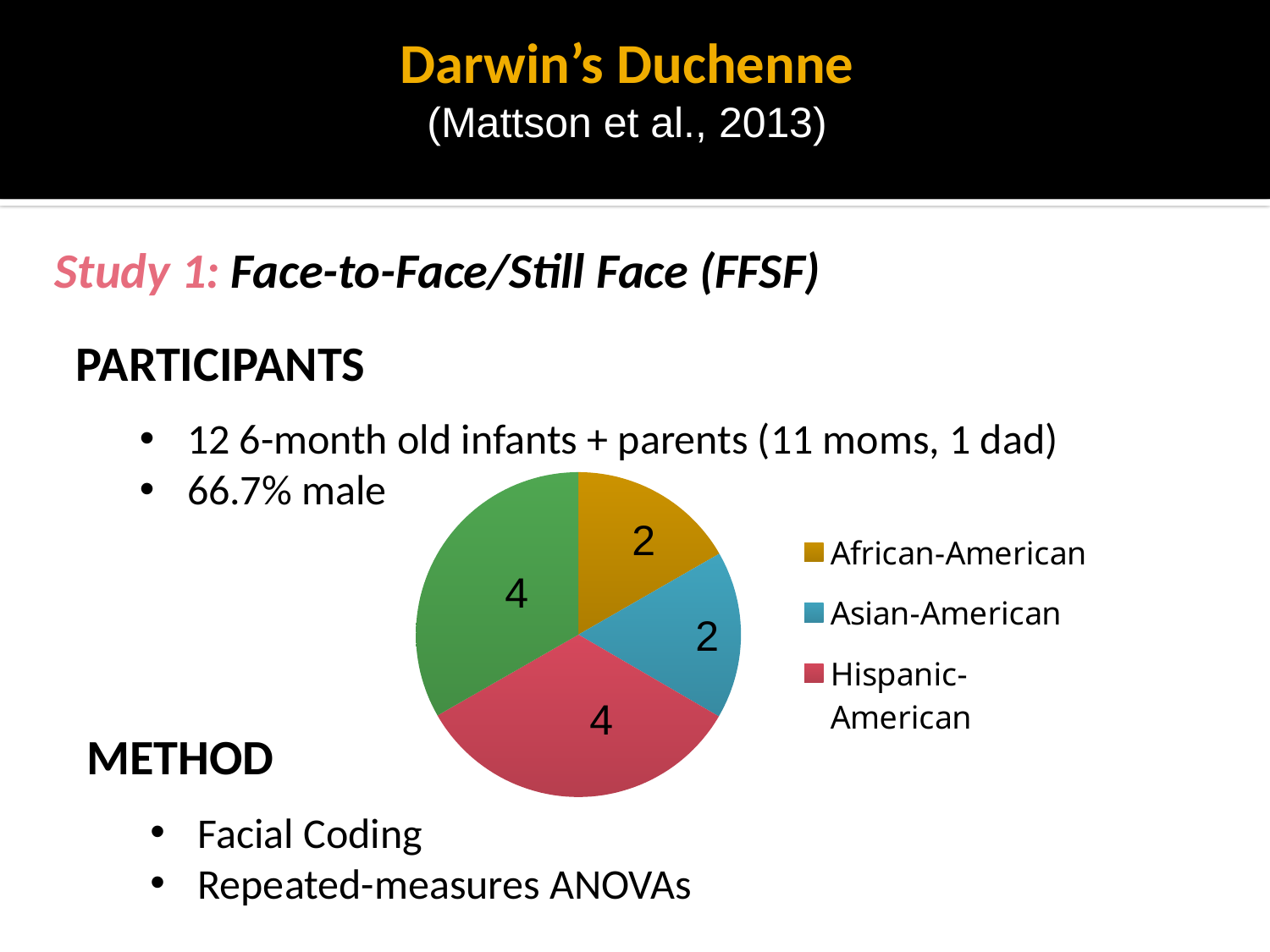
What type of chart is shown on the slide? pie chart What is the value for Hispanic-American in the pie chart? 4 What is the difference between the Hispanic-American and Asian-American values in the pie chart? 2 What colour is the Hispanic-American slice in the pie chart? red How many slices does the pie chart have? 4 What is the value for Asian-American in the pie chart? 2 What colour is the African-American slice in the pie chart? gold What is the difference between the Hispanic-American and African-American values in the pie chart? 2 Which is larger in the pie chart, Hispanic-American or Asian-American? Hispanic-American Which is larger in the pie chart, Hispanic-American or African-American? Hispanic-American What is the value for African-American in the pie chart? 2 How many entries are listed in the pie chart's legend? 3